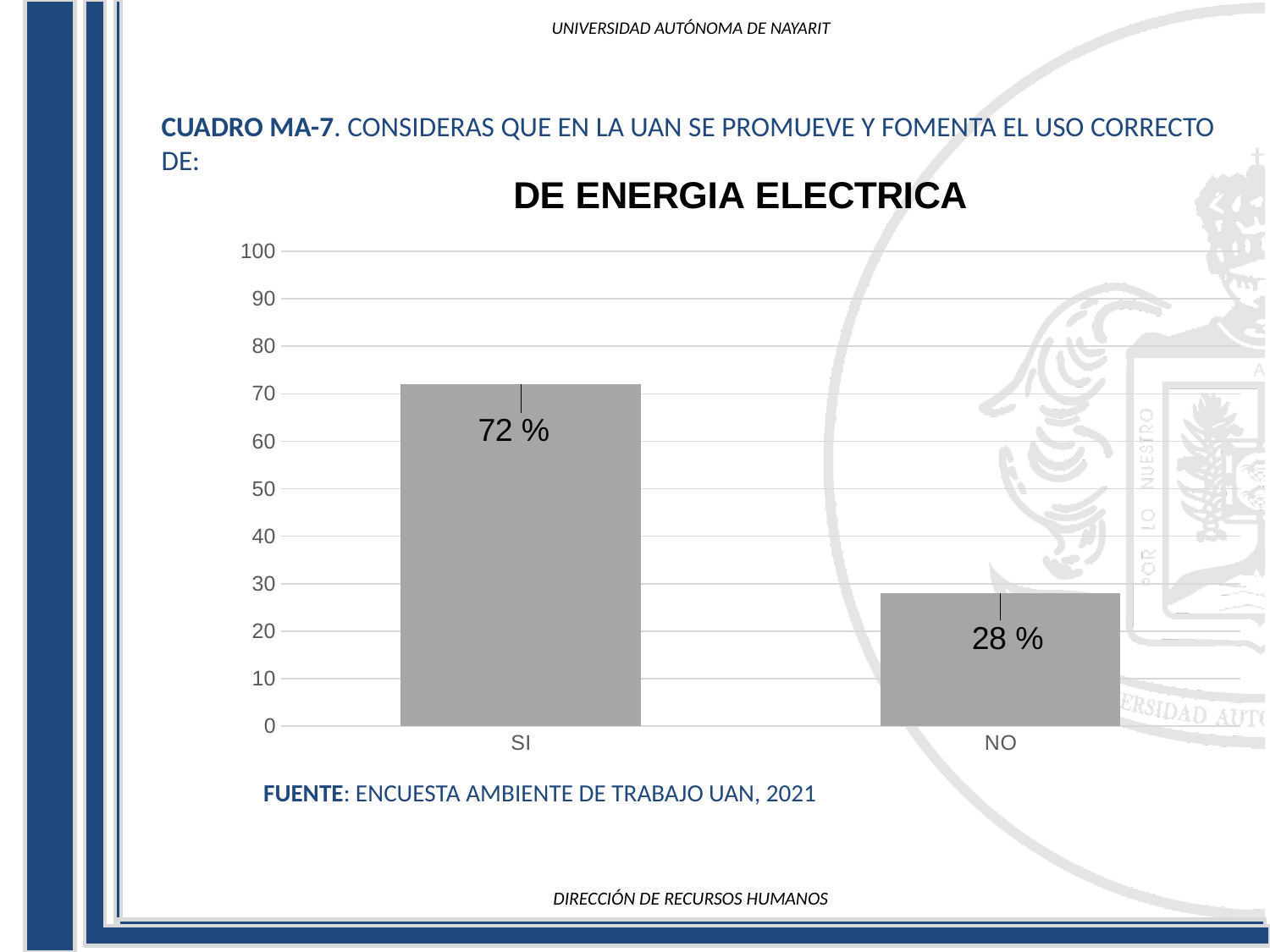
What is the value for SI? 72 % What is the title of the chart? DE ENERGIA ELECTRICA What kind of chart is shown? bar chart Which category has the lowest value? NO What is the highest value shown on the y axis? 100 Is the value for SI greater or less than 50? greater What is the value for NO? 28 % Which category has the highest value? SI What is the difference between the values for SI and NO? 44 % How many categories are shown on the x axis? 2 Is the value for NO greater or less than 30? less Which is larger, the value for SI or the value for NO? SI